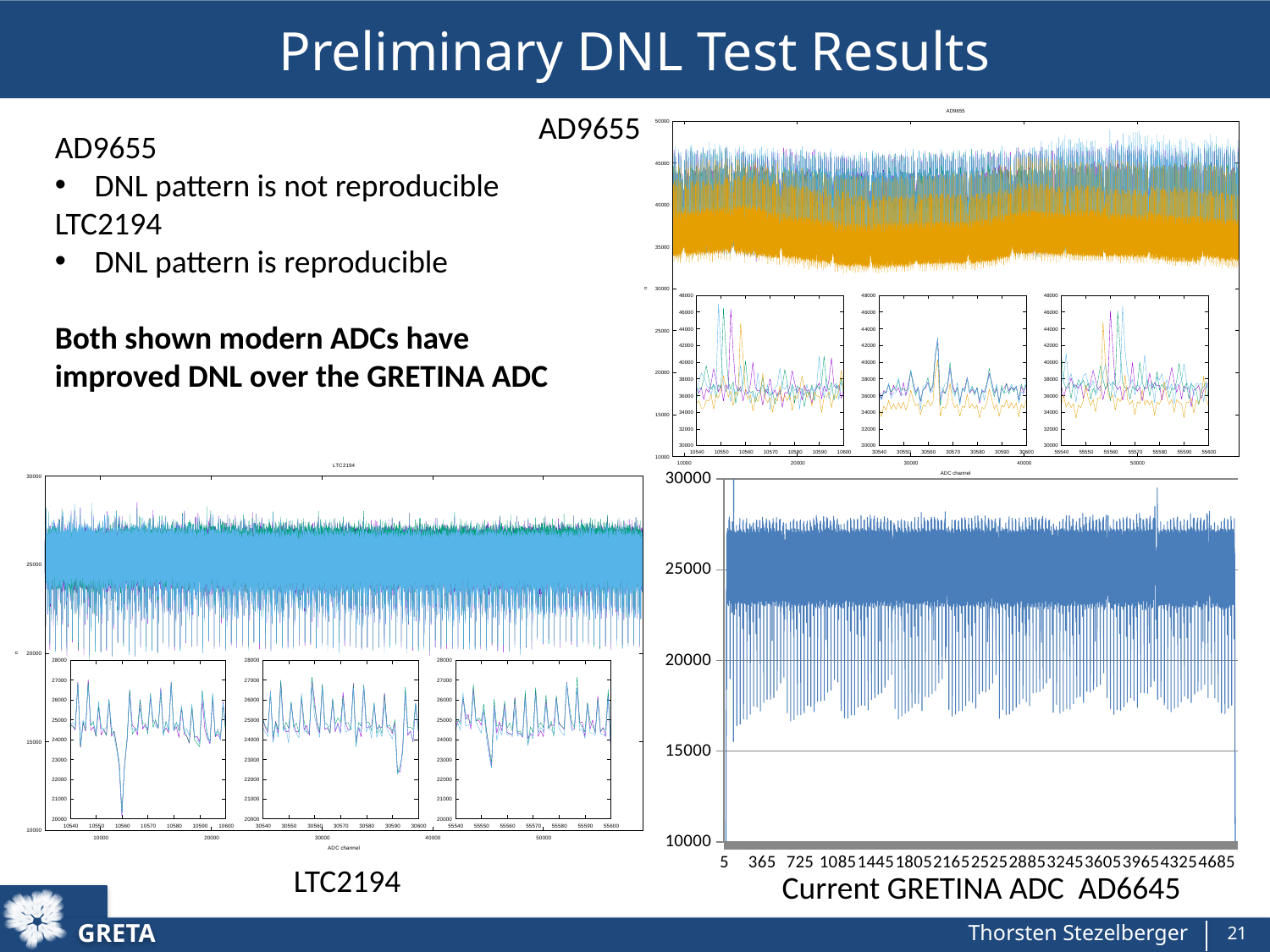
What kind of chart is the Current GRETINA ADC AD6645 chart at the bottom right of the slide? line chart In the AD9655 chart, is the lower edge of the orange band greater or less than 30000? greater What kind of chart is the AD9655 chart at the top right of the slide? line chart What is the title printed above the chart at the bottom left of the slide? LTC2194 What is the highest y-axis tick shown on the Current GRETINA ADC AD6645 chart? 30000 In the Current GRETINA ADC AD6645 chart, is the upper edge of the dense blue band greater or less than 25000? greater What kind of chart is the LTC2194 chart at the bottom left of the slide? line chart